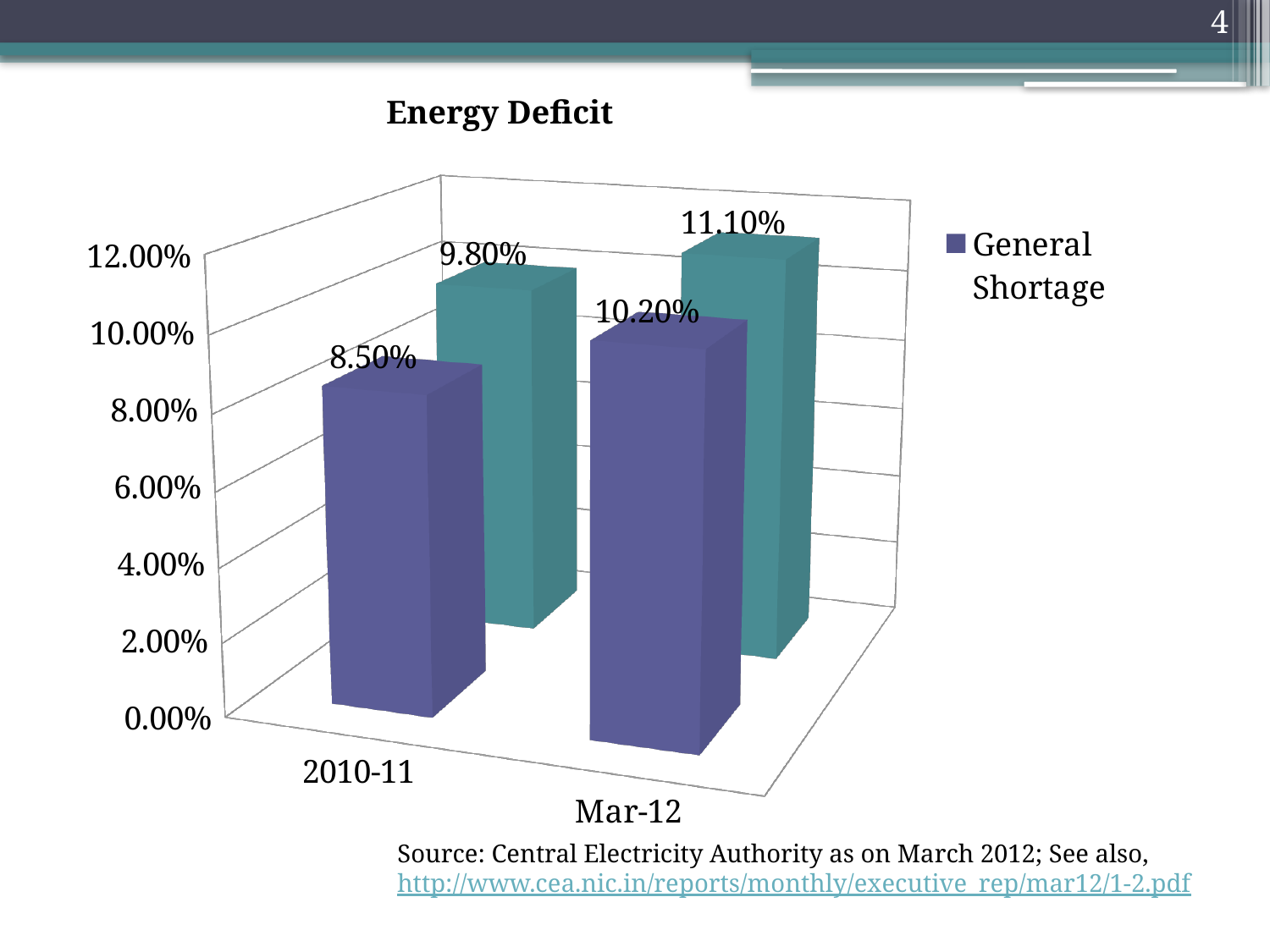
What type of chart is shown on the slide? bar chart Which bar has the highest labelled value on the chart? the teal bar for Mar-12 (11.10%) Which category has the higher General Shortage value, 2010-11 or Mar-12? Mar-12 What is the difference between the teal bar values for Mar-12 and 2010-11? 1.30% How many categories are shown on the x axis? 2 What is the difference between the General Shortage values for Mar-12 and 2010-11? 1.70% What is the title of the chart? Energy Deficit What value is labelled on the teal bar for 2010-11? 9.80% What is the General Shortage value for 2010-11? 8.50% What is the General Shortage value for Mar-12? 10.20% What value is labelled on the teal bar for Mar-12? 11.10% Does the General Shortage value rise or fall from 2010-11 to Mar-12? rise